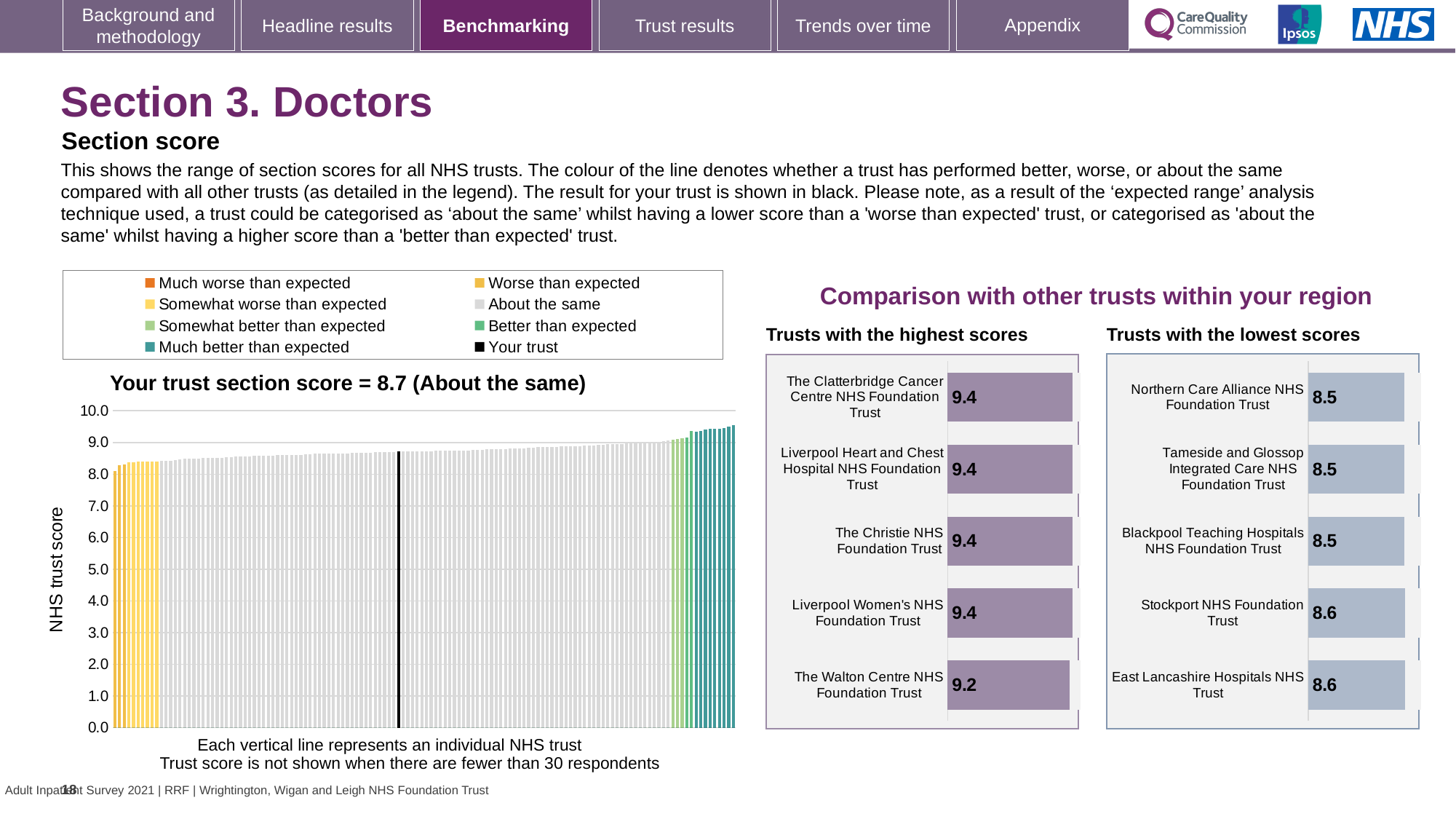
What kind of chart is the 'Your trust section score' chart? bar chart In the 'Trusts with the highest scores' chart, how many trusts are shown? 5 How many entries does the legend above the 'Your trust section score' chart list? 8 In the 'Trusts with the lowest scores' chart, what is the score for Stockport NHS Foundation Trust? 8.6 What is the y-axis label of the 'Your trust section score' chart? NHS trust score In the 'Trusts with the lowest scores' chart, which has the larger score: Northern Care Alliance NHS Foundation Trust or East Lancashire Hospitals NHS Trust? East Lancashire Hospitals NHS Trust In the 'Your trust section score' chart, do the trust scores rise or fall from left to right along the x axis? rise In the 'Your trust section score' chart, what is the section score for your trust? 8.7 In the 'Trusts with the highest scores' chart, which trust has the lowest score? The Walton Centre NHS Foundation Trust In the 'Trusts with the highest scores' chart, what is the score for The Walton Centre NHS Foundation Trust? 9.2 In the 'Your trust section score' chart, which category is your trust placed in? About the same In the 'Trusts with the highest scores' chart, what is the difference between the scores of The Clatterbridge Cancer Centre NHS Foundation Trust and The Walton Centre NHS Foundation Trust? 0.2